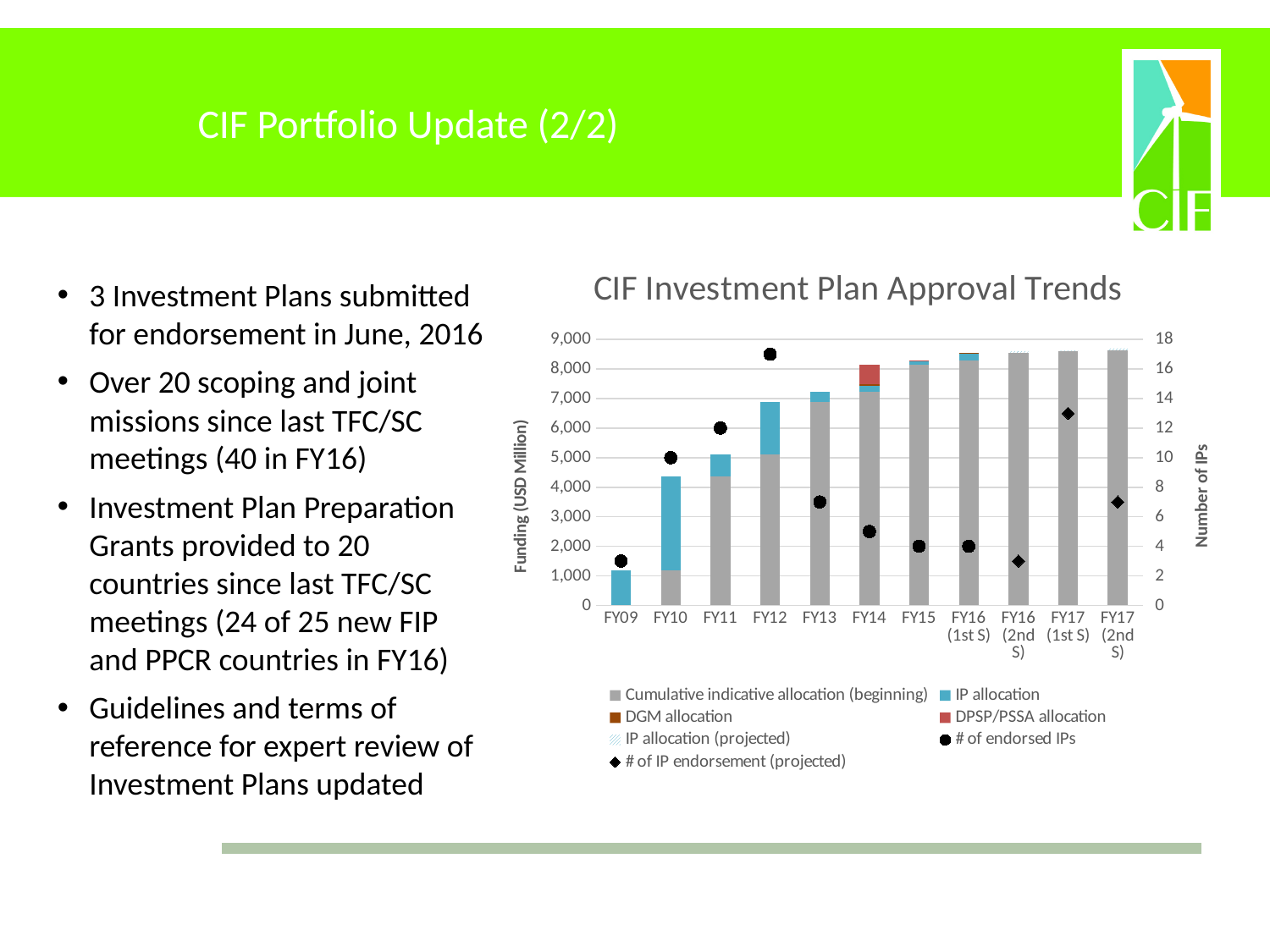
Is the number of endorsed IPs for FY09 greater or less than 4? less What is the title of the chart? CIF Investment Plan Approval Trends Which fiscal year has the lowest number of endorsed IPs? FY09 Which has a larger total bar height, FY11 or FY13? FY13 Is the total bar height for FY09 greater or less than 2,000? less How many series does the legend list? 7 What is the label of the right-hand vertical axis? Number of IPs How many categories are shown on the x axis? 11 Is the total bar height for FY12 greater or less than 6,000? greater What kind of chart is used to show the funding allocations? Stacked bar chart Which fiscal year has the highest number of endorsed IPs? FY12